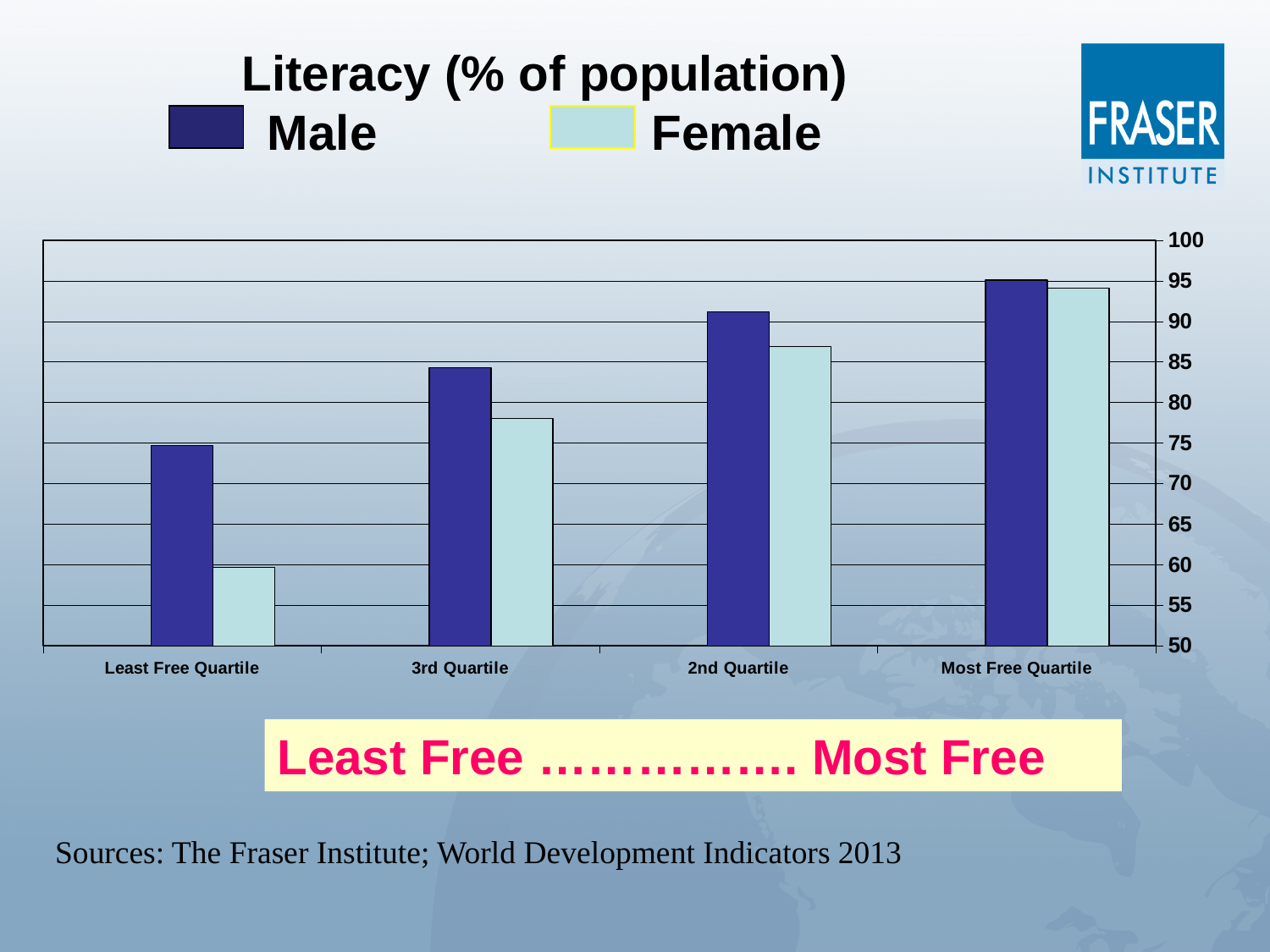
Is the Female literacy value for the 3rd Quartile greater or less than 80? less Which quartile has the highest Male literacy rate? Most Free Quartile How many quartile categories are shown on the x axis? 4 Is the Female literacy value for the Least Free Quartile greater or less than 65? less Is the Female literacy value for the Most Free Quartile greater or less than 90? greater Which quartile has the lowest Female literacy rate? Least Free Quartile Do the Male literacy values rise or fall moving from the Least Free Quartile to the Most Free Quartile? rise What kind of chart is shown on the slide? bar chart In the Least Free Quartile, is the Male or the Female literacy rate larger? Male How many series does the legend list? 2 What is the title of the chart? Literacy (% of population)